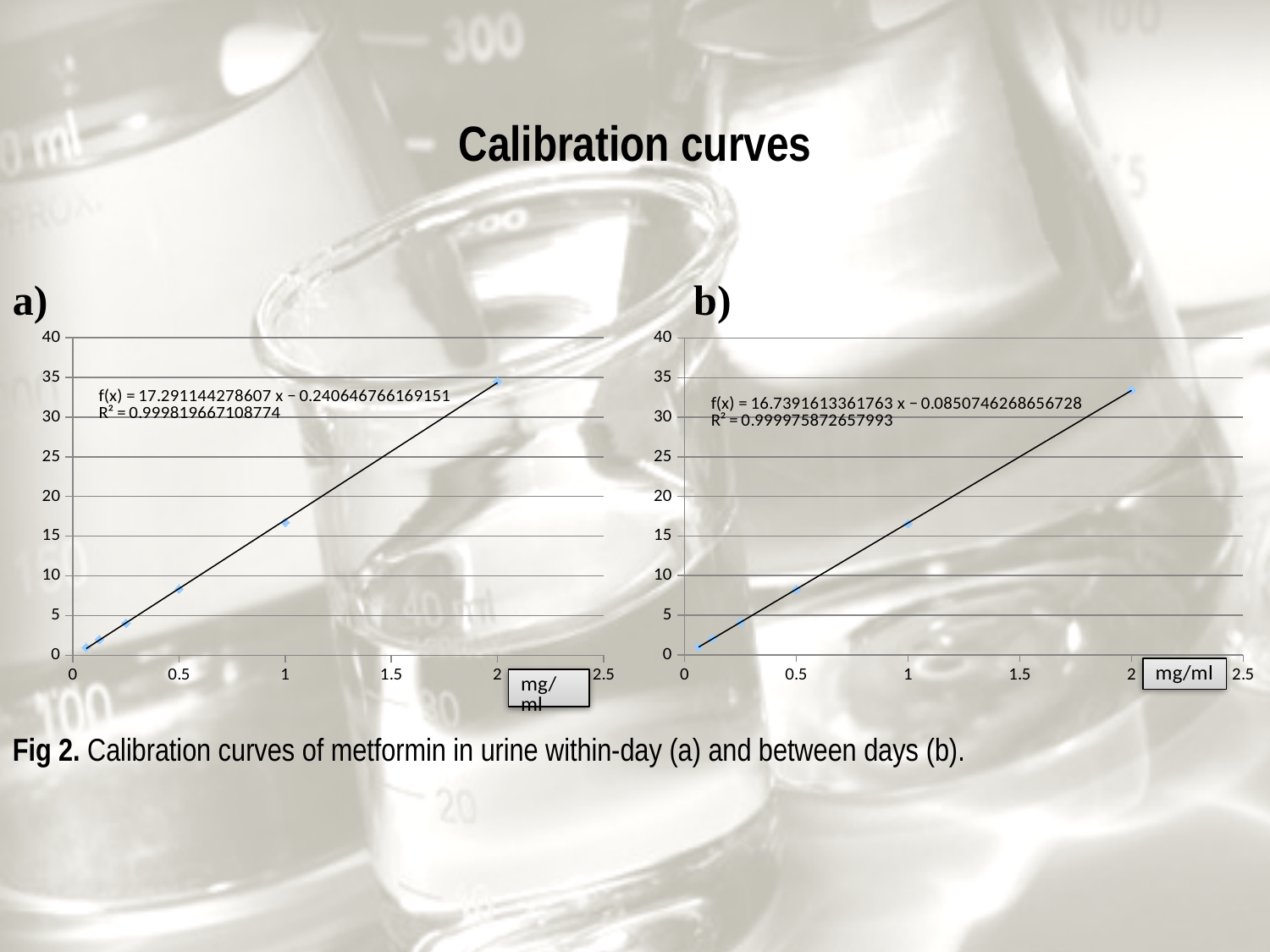
What kind of chart is chart a)? Scatter chart with a trendline In chart a), is the value at x = 1 greater or less than 20? less In chart b), is the value at x = 2 greater or less than 30? greater In chart a), is the value at x = 2 greater or less than 30? greater How many data points are plotted in chart b)? 6 In chart a), do the plotted values rise or fall as the x axis increases? Rise In chart b), do the plotted values rise or fall as the x axis increases? Rise What R² value is printed on chart b)? R² = 0.999975872657993 What is the x-axis unit label shown on chart a)? mg/ml How many data points are plotted in chart a)? 6